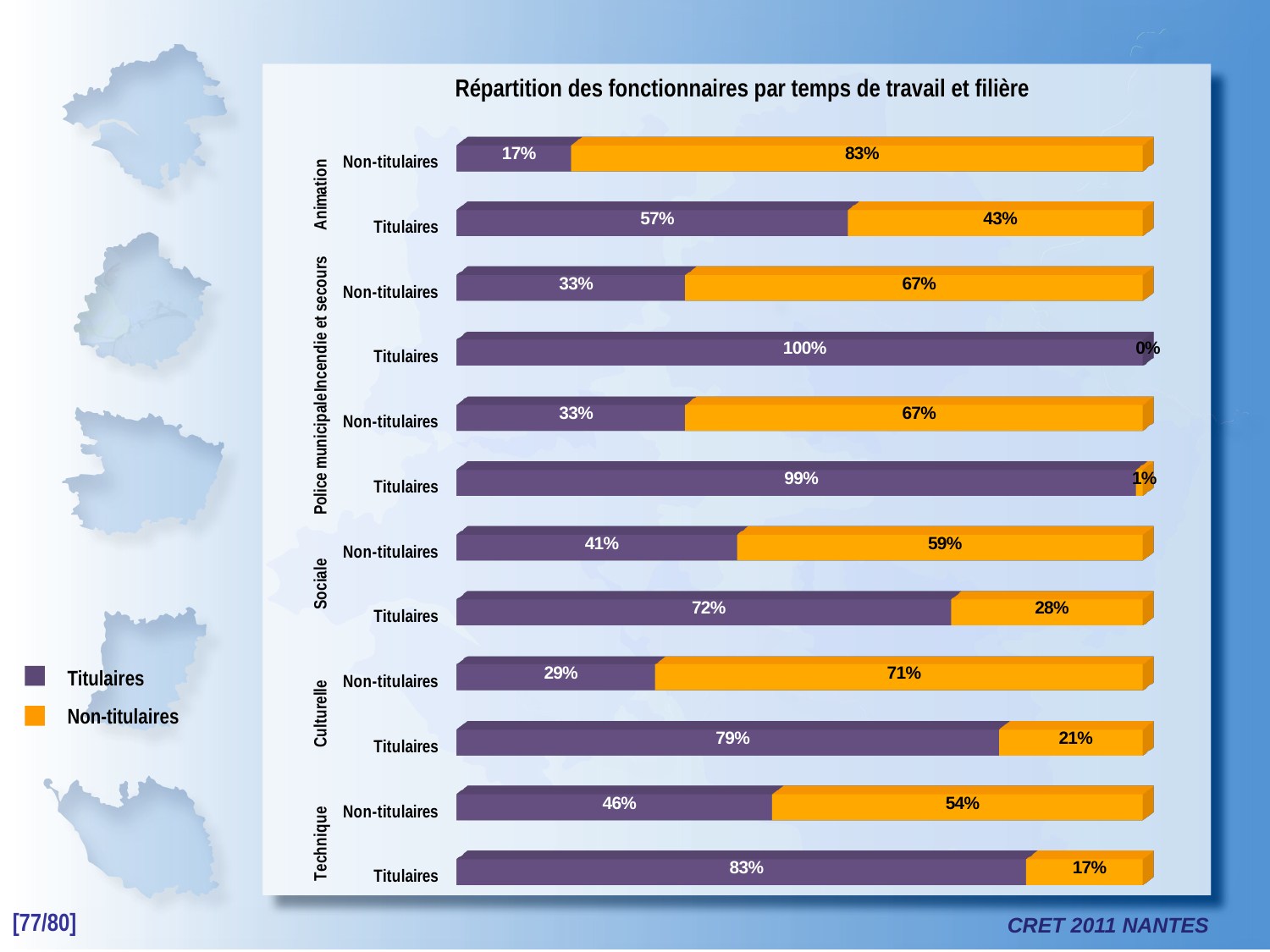
What is the Titulaires (purple) value for the Incendie et secours Titulaires bar? 100% Which is larger: the Titulaires (purple) value for Culturelle Titulaires or for Sociale Titulaires? Culturelle Titulaires Which bar has the lowest Titulaires (purple) value? Animation Non-titulaires What type of chart is shown on the slide? Stacked bar chart How many bars are plotted in the chart? 12 Which bar has the highest Non-titulaires (orange) value? Animation Non-titulaires How many series does the legend list? 2 What are the two series named in the legend? Titulaires and Non-titulaires What is the title of the chart? Répartition des fonctionnaires par temps de travail et filière What is the Non-titulaires (orange) value for the Sociale Titulaires bar? 28% What is the difference between the Titulaires (purple) values of the Technique Titulaires bar and the Technique Non-titulaires bar? 37% What is the Titulaires (purple) value for the Animation Non-titulaires bar? 17%